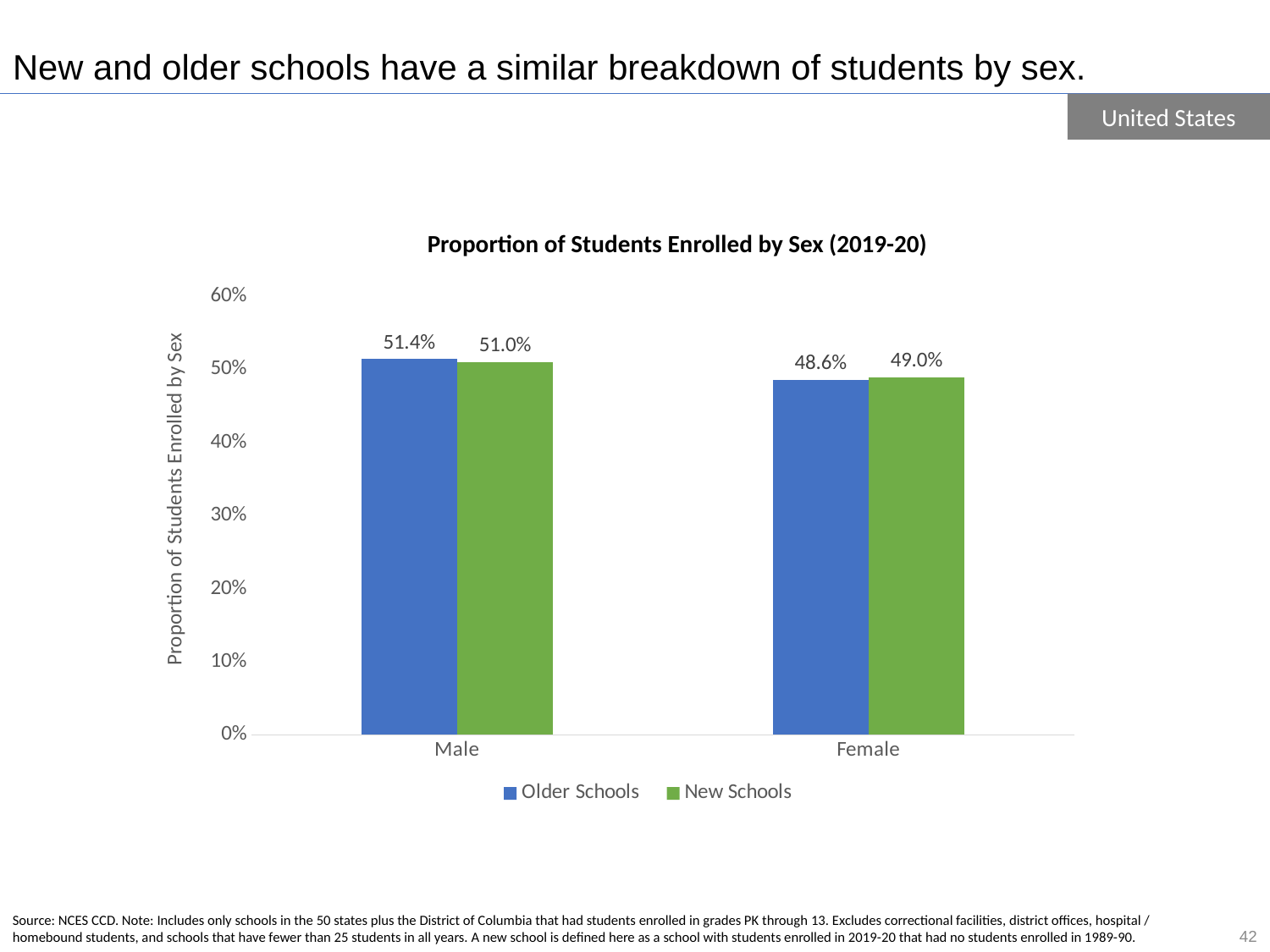
What is the difference between the Older Schools and New Schools values for Male? 0.4% What is the value for Female in the New Schools series? 49.0% What kind of chart is shown on the slide? bar chart Which is larger for Female: Older Schools or New Schools? New Schools What is the value for Male in the New Schools series? 51.0% How many categories are shown on the x axis? 2 Which category has the highest value in the Older Schools series? Male How many series does the legend list? 2 What is the value for Male in the Older Schools series? 51.4% Which category has the lowest value in the New Schools series? Female What is the value for Female in the Older Schools series? 48.6% Is the value for Female in the Older Schools series greater or less than 50%? less